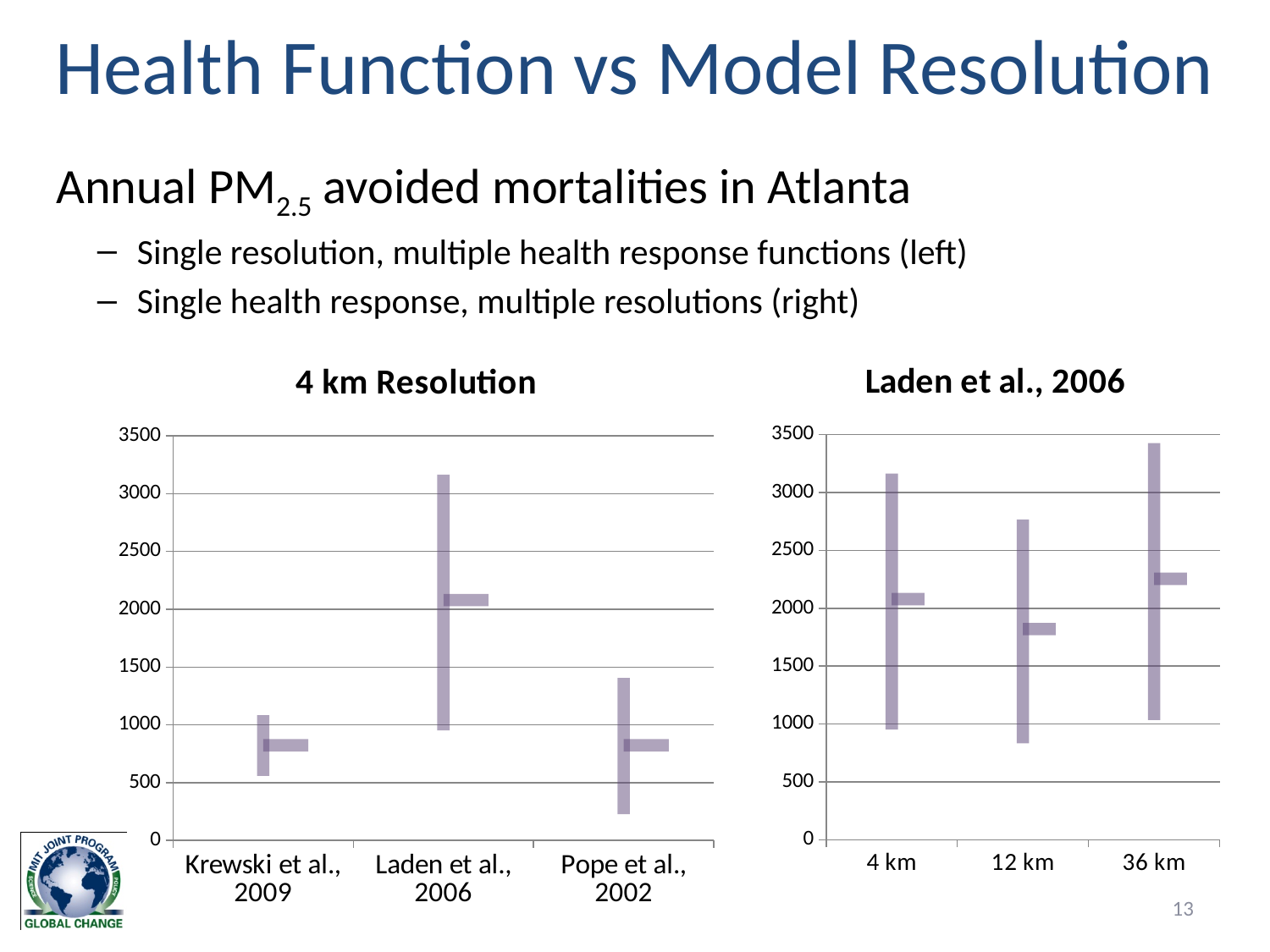
On the Laden et al., 2006 chart, how many model resolutions are shown on the x axis? 3 On the 4 km Resolution chart, which health response function has the highest central estimate? Laden et al., 2006 On the 4 km Resolution chart, how many health response functions (categories) are shown on the x axis? 3 On the Laden et al., 2006 chart, which resolution has the highest central estimate? 36 km On the 4 km Resolution chart, is the central estimate for Laden et al., 2006 greater or less than 2000? greater On the 4 km Resolution chart, which health response function has the widest range between its upper and lower ends? Laden et al., 2006 On the Laden et al., 2006 chart, which resolution has the lowest central estimate? 12 km On the Laden et al., 2006 chart, is the central estimate for 12 km greater or less than 2000? less On the Laden et al., 2006 chart, is the central estimate for 36 km larger or smaller than the central estimate for 12 km? larger On the 4 km Resolution chart, is the central estimate for Krewski et al., 2009 greater or less than 1000? less